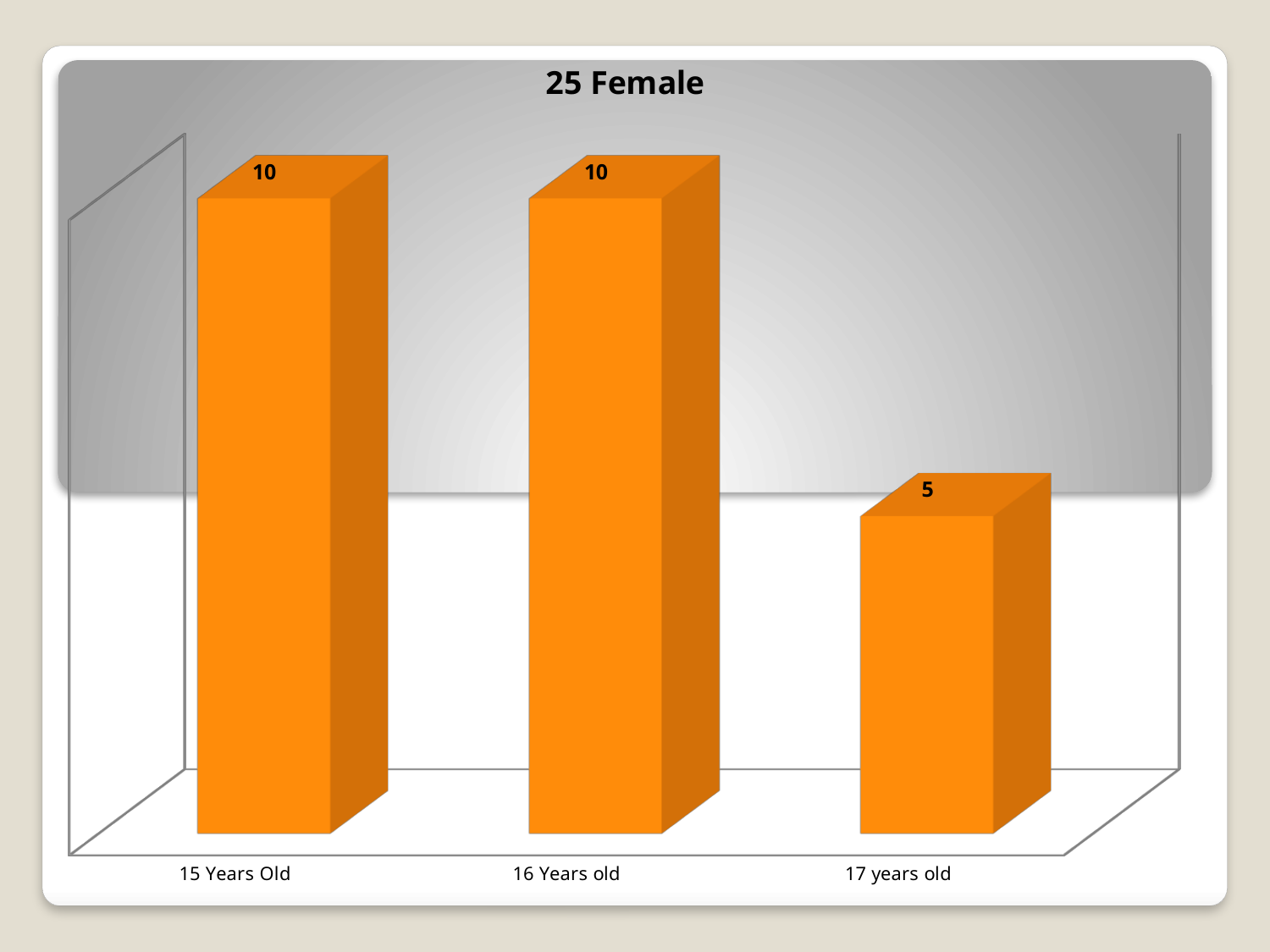
Which is larger, the value for 16 Years old or the value for 17 years old? 16 Years old What kind of chart is shown on the slide? bar chart What is the value for 17 years old? 5 What is the value for 16 Years old? 10 What is the total of all three values shown in the chart? 25 What is the value for 15 Years Old? 10 What colour are the bars in the chart? orange Which category has the lowest value? 17 years old What is the difference between the values for 15 Years Old and 17 years old? 5 What is the title of the chart? 25 Female How many categories are shown on the x axis? 3 Do the values for 15 Years Old and 16 Years old differ? No, both are 10